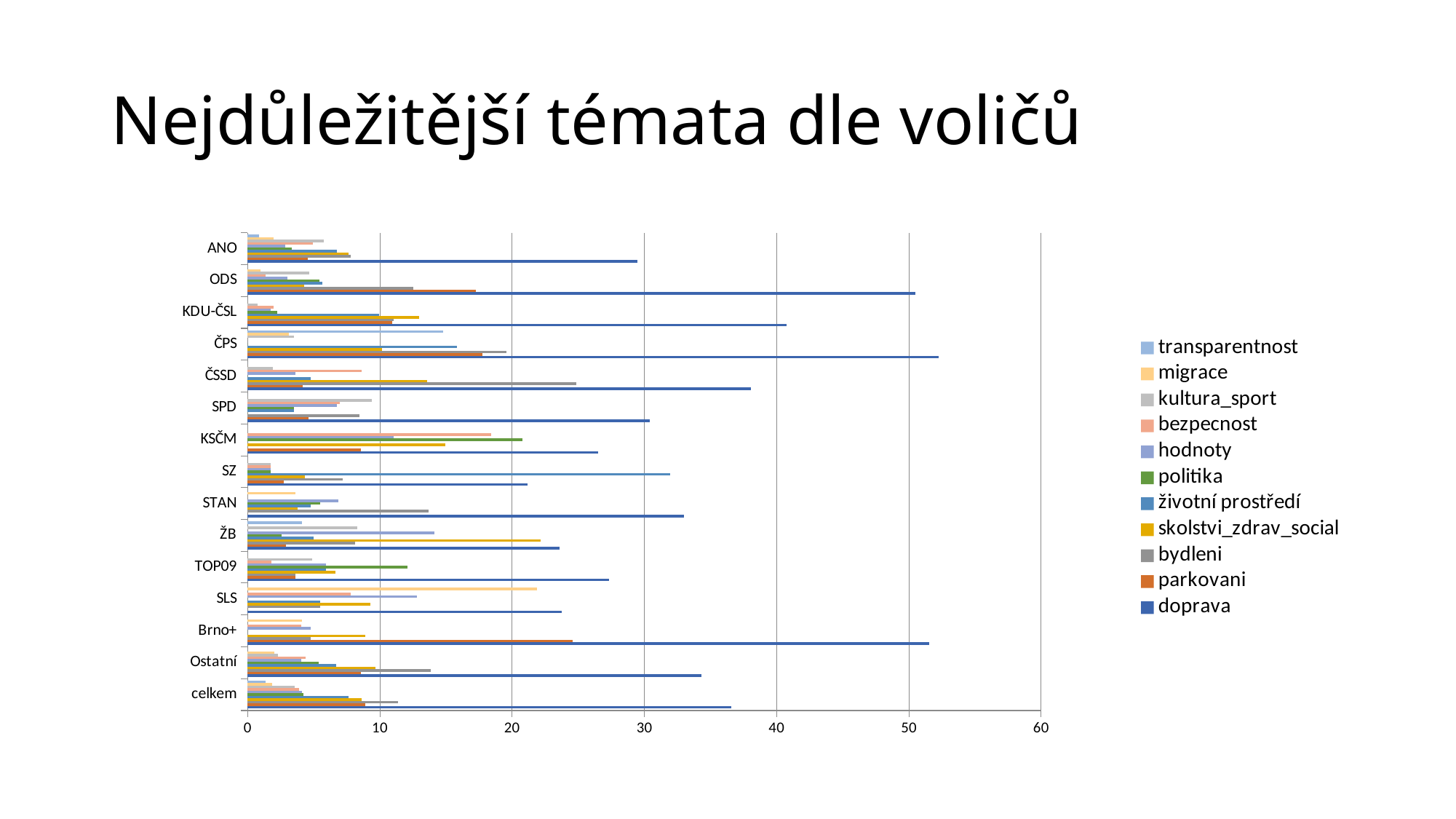
Is the value of životní prostředí for SZ greater or less than 30? greater Is the value of doprava for ODS greater or less than 40? greater What is the title of the slide containing the chart? Nejdůležitější témata dle voličů Is the value of bydleni for ČSSD greater or less than 20? greater How many categories (parties/groups) are listed on the vertical axis of the chart? 15 How many series does the chart's legend list? 11 Which is larger, the doprava value for ODS or the doprava value for ANO? ODS What kind of chart is shown on the slide? bar chart Which series is listed last in the chart's legend? doprava